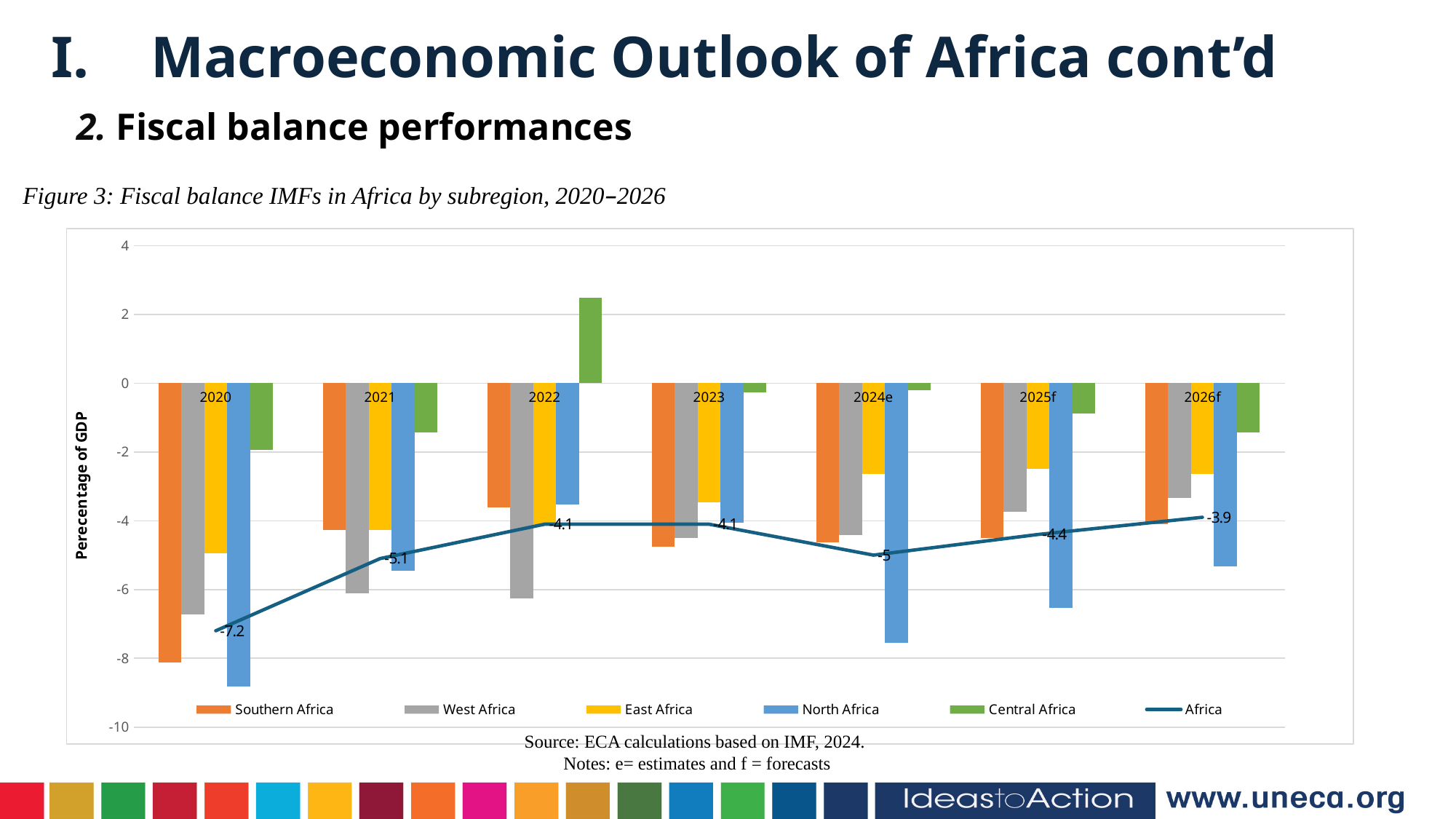
In which year is the Africa line at its lowest value? 2020 How many years are shown on the x axis of the chart? 7 Which subregion has a positive fiscal balance in 2022? Central Africa How many series does the legend list? 6 What kind of chart is shown in Figure 3? Bar chart with a line What is the value of the Africa line for 2024e? -5 What is the value of the Africa line for 2020? -7.2 Is the value for North Africa in 2020 greater or less than -8? less In which year is the Africa line at its highest value? 2026f What is the value of the Africa line for 2026f? -3.9 By how much does the Africa line value change between 2020 (-7.2) and 2026f (-3.9)? 3.3 Does the Africa line rise or fall from 2020 to 2022? Rise